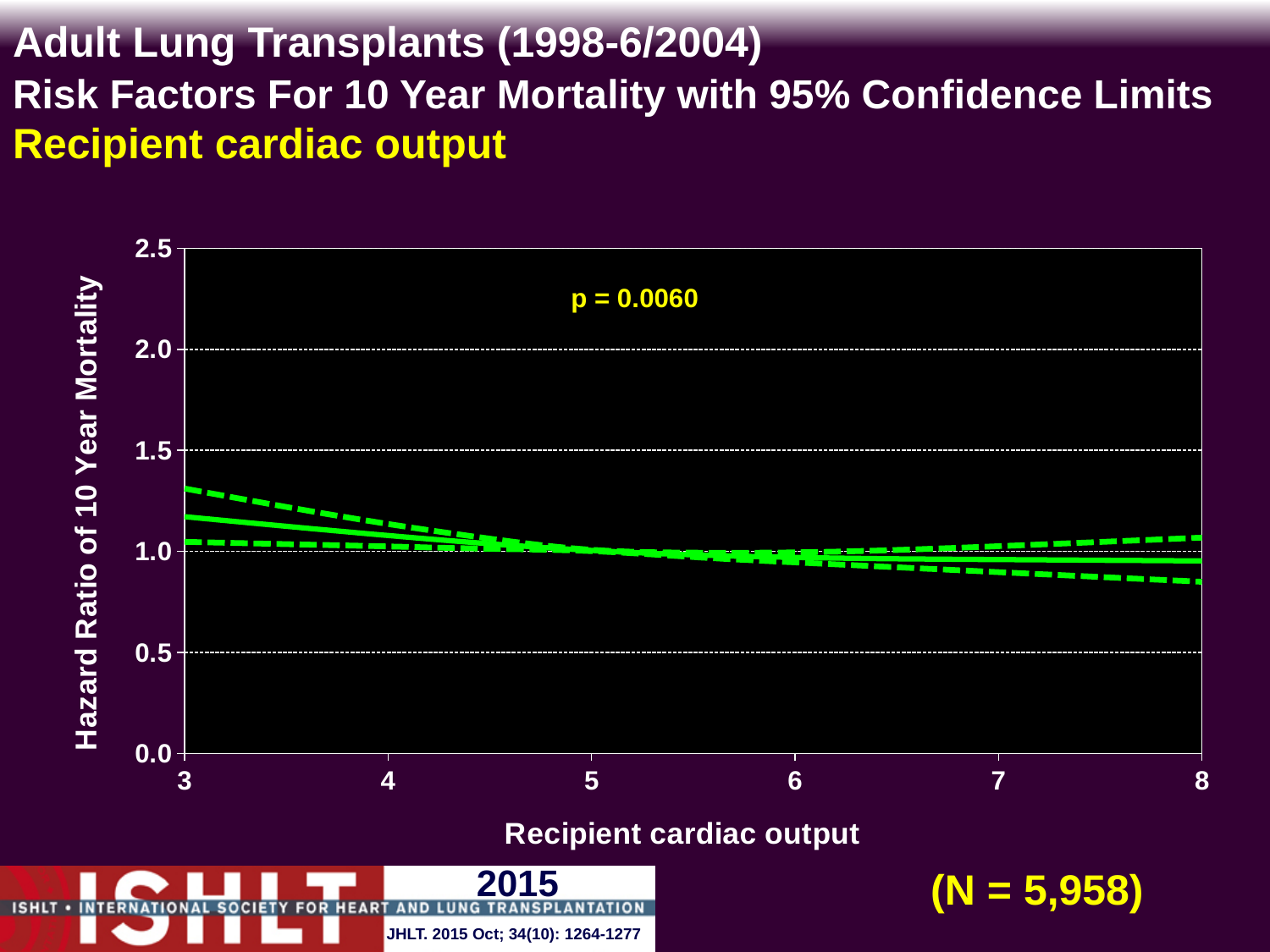
What is the label of the x axis? Recipient cardiac output Is the hazard ratio at a recipient cardiac output of 3 larger or smaller than the hazard ratio at a recipient cardiac output of 8? larger What kind of chart is shown on the slide? line chart Is the lower 95% confidence limit at a recipient cardiac output of 8 greater or less than 1.0? less Is the upper 95% confidence limit at a recipient cardiac output of 3 greater or less than 1.5? less What p-value is printed on the chart? p = 0.0060 Does the hazard ratio rise or fall as recipient cardiac output increases from 3 to 8? fall What is the highest value shown on the y axis? 2.5 Is the hazard ratio of 10 year mortality at a recipient cardiac output of 3 greater or less than 1.5? less How many lines are plotted on the chart (the estimate plus its confidence limits)? 3